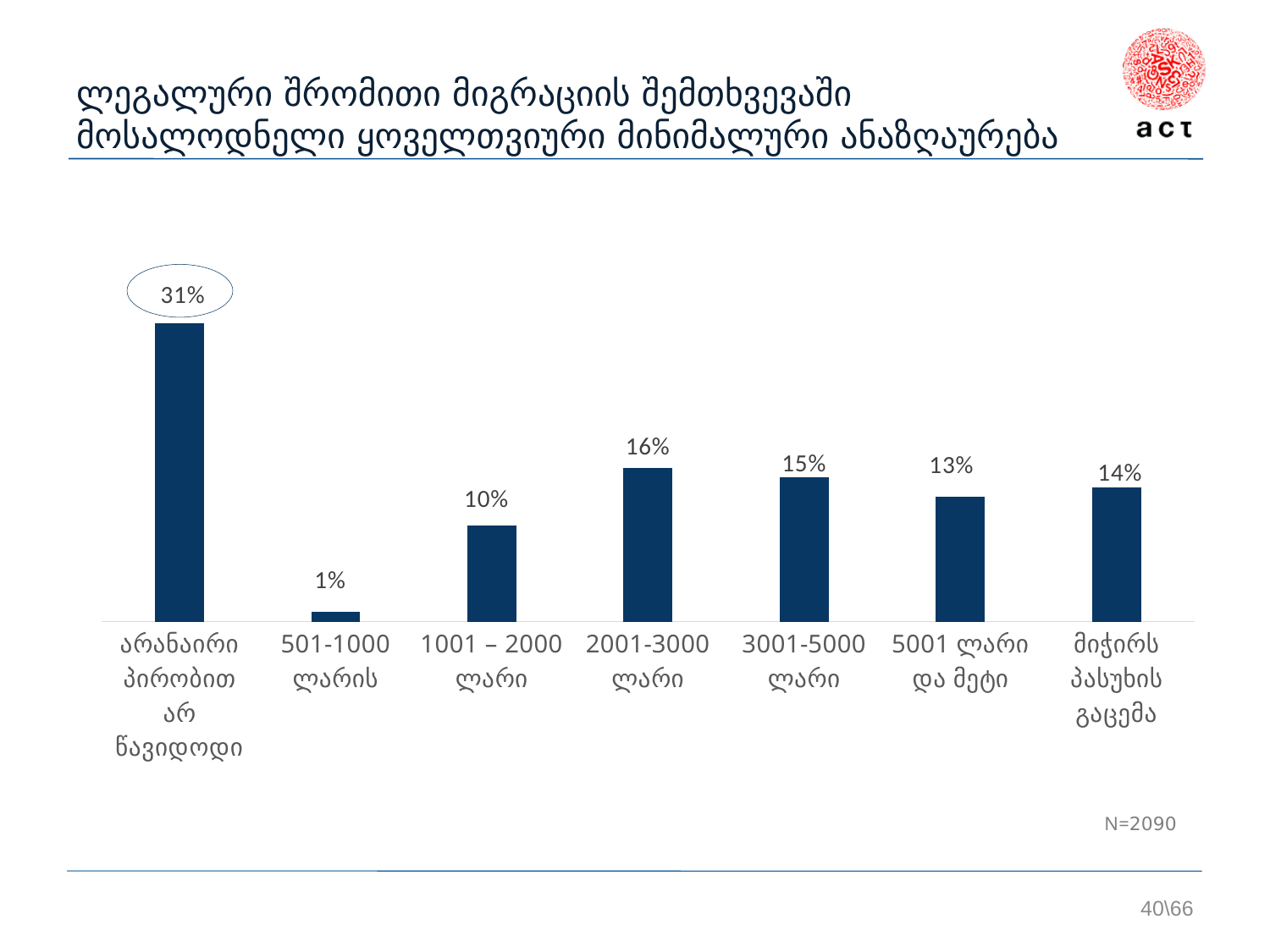
Which category has the highest value? არანაირი პირობით არ წავიდოდი What type of chart is shown on the slide? Bar chart What is the difference between the "არანაირი პირობით არ წავიდოდი" bar and the "2001-3000 ლარი" bar? 15% What percentage is shown for the "2001-3000 ლარი" category? 16% What is the difference between the "1001 – 2000 ლარი" and "3001-5000 ლარი" values? 5% What sample size (N) is noted on the slide? N=2090 Which category has the lowest value? 501-1000 ლარის What is the value for the "მიჭირს პასუხის გაცემა" category? 14% What is the value for the "501-1000 ლარის" bar? 1% What percentage is shown for "5001 ლარი და მეტი"? 13% How many categories are shown on the chart? 7 Which is larger, the value for "3001-5000 ლარი" or for "5001 ლარი და მეტი"? 3001-5000 ლარი